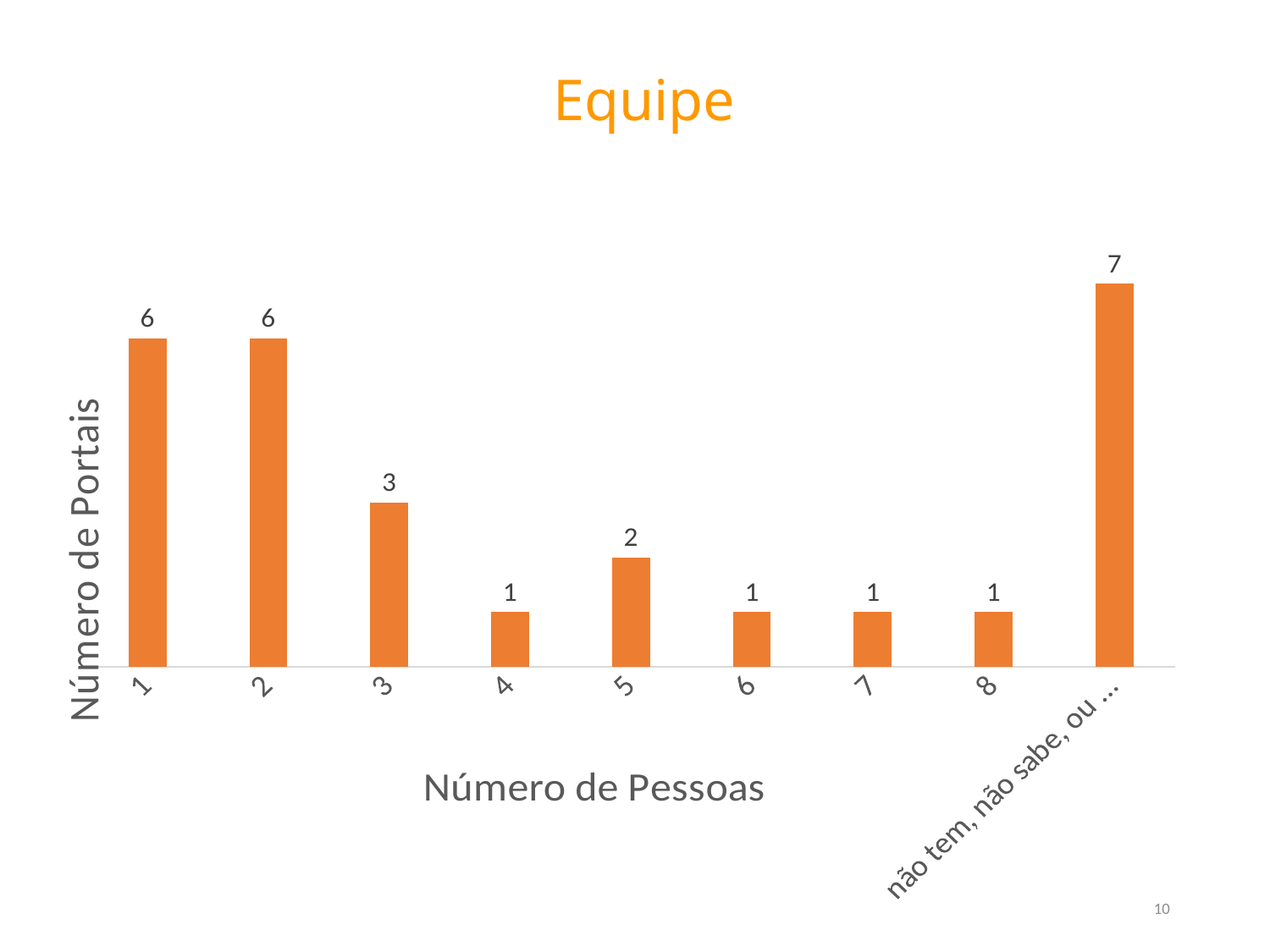
What is the difference in number of portals between the 'não tem, não sabe, ou ...' category and teams with 2 people? 1 Which category has the highest number of portals? não tem, não sabe, ou ... How many categories are shown on the x axis? 9 What kind of chart is shown on the slide? Bar chart What is the number of portals for teams with 3 people? 3 What is the title of the x axis? Número de Pessoas What is the number of portals for teams with 5 people? 2 What is the title of the y axis? Número de Portais Which has more portals: teams with 3 people or teams with 5 people? 3 people What is the number of portals for teams with 1 person? 6 What is the difference in number of portals between teams with 1 person and teams with 3 people? 3 What is the number of portals for the category 'não tem, não sabe, ou ...'? 7